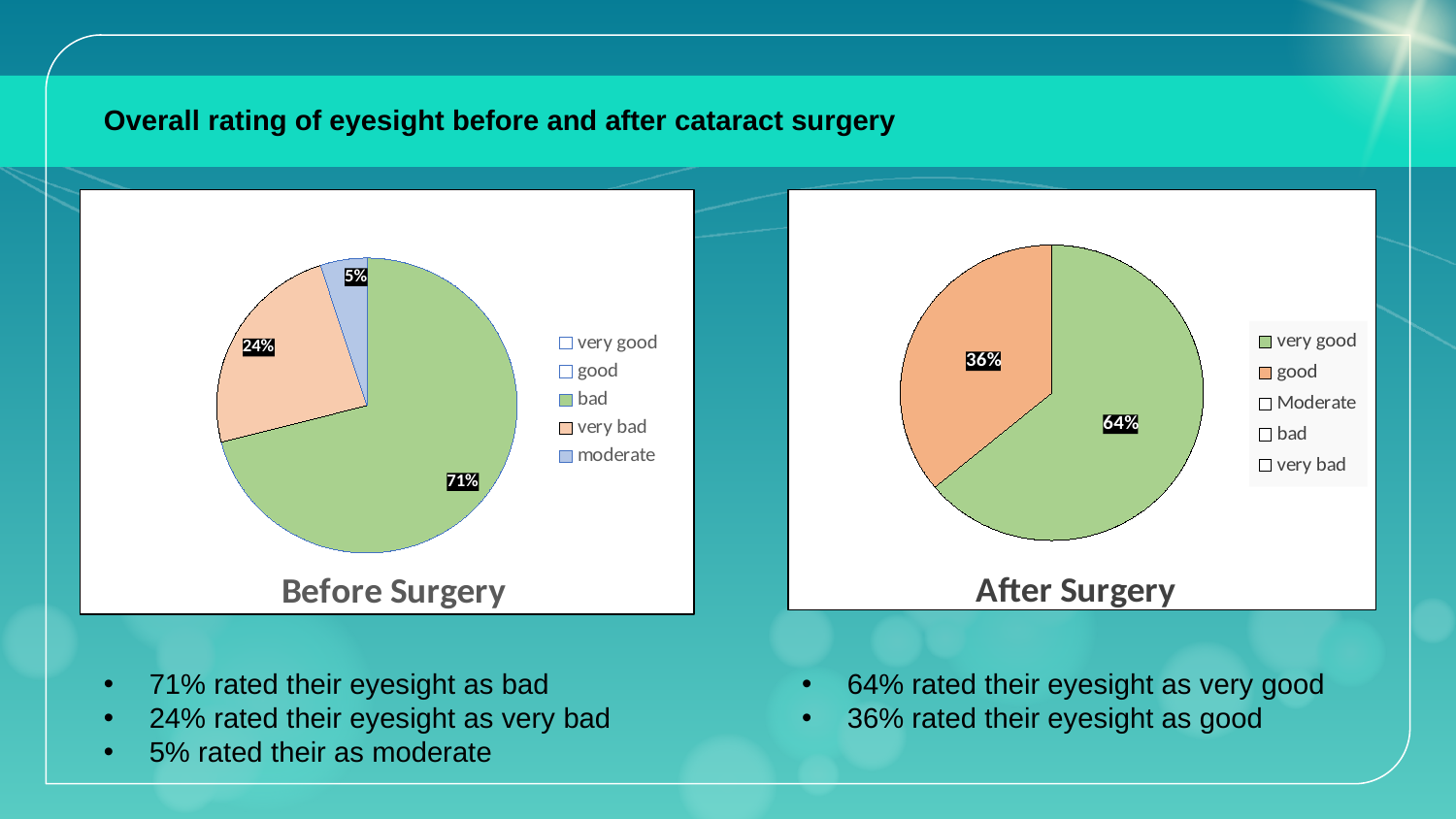
In the Before Surgery chart, which category has the largest slice? bad In the After Surgery chart, which is larger, very good or good? very good In the Before Surgery chart, what is the difference between the bad and very bad slices? 47% How many entries does the legend of the After Surgery chart list? 5 What type of chart is the Before Surgery chart? pie chart In the Before Surgery chart, which category has the smallest labelled slice? moderate In the Before Surgery chart, what percentage rated their eyesight as very bad? 24% In the Before Surgery chart, what percentage rated their eyesight as bad? 71% In the After Surgery chart, what percentage rated their eyesight as good? 36% In the Before Surgery chart, what percentage rated their eyesight as moderate? 5% In the After Surgery chart, what percentage rated their eyesight as very good? 64% In the After Surgery chart, what is the difference between the very good and good slices? 28%